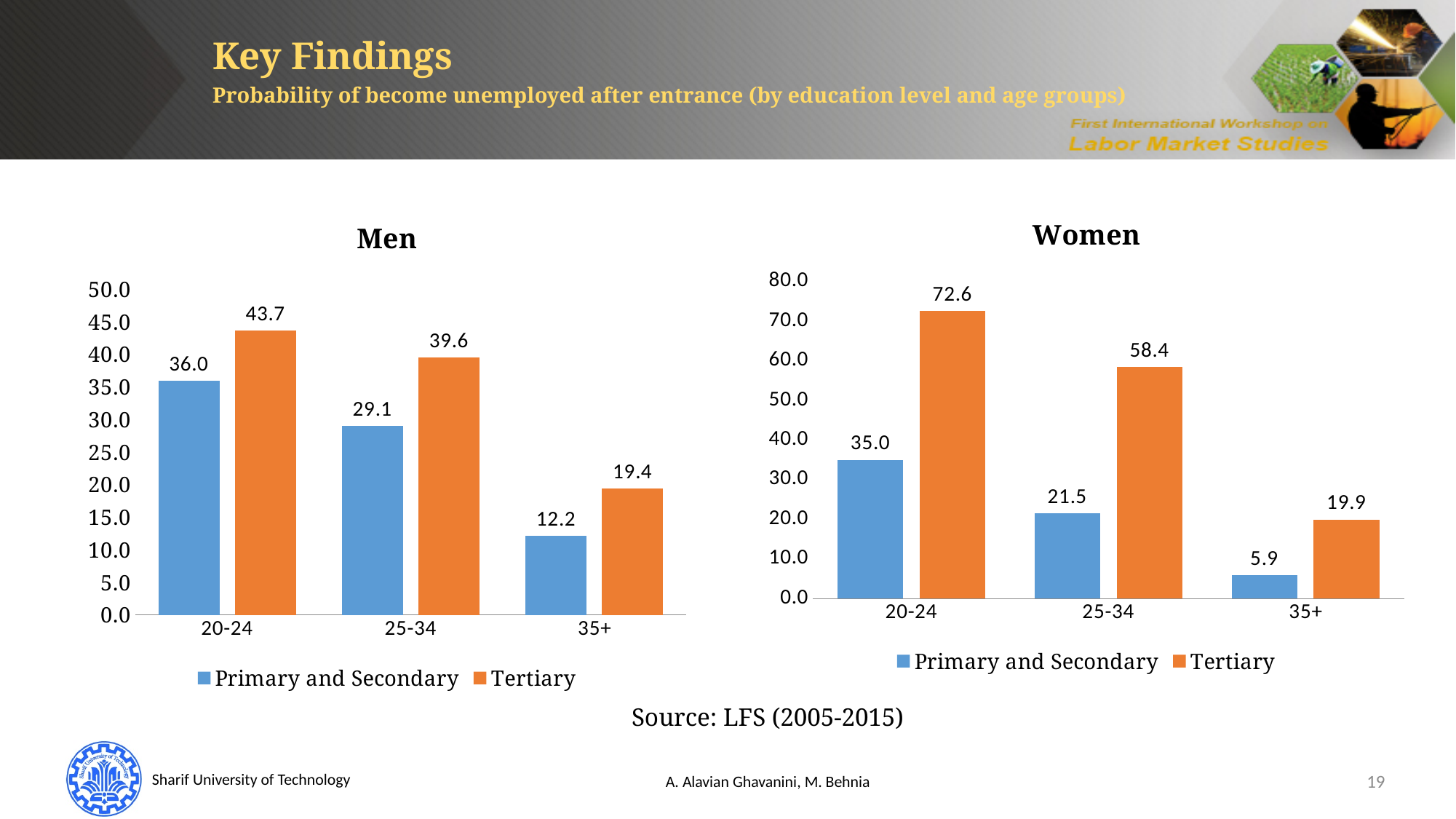
In the Women chart, is the Tertiary value for 25-34 greater or less than 50.0? greater In the Women chart, do the Primary and Secondary values rise or fall from 20-24 to 35+? Fall In the Men chart, what is the difference between the Primary and Secondary values for 20-24 and 25-34? 6.9 How many series does the legend of the Women chart list? 2 In the Men chart, which age group has the lowest Primary and Secondary value? 35+ In the Women chart, which age group has the highest Tertiary value? 20-24 In the Women chart, what is the value for Primary and Secondary in the 25-34 age group? 21.5 What kind of chart is the Women chart? Bar chart How many age groups are shown on the x axis of the Men chart? 3 In the Women chart, what is the difference between the Tertiary and Primary and Secondary values for the 20-24 age group? 37.6 In the Men chart, which is larger for the 35+ age group: Primary and Secondary or Tertiary? Tertiary In the Men chart, what is the value for Tertiary in the 20-24 age group? 43.7